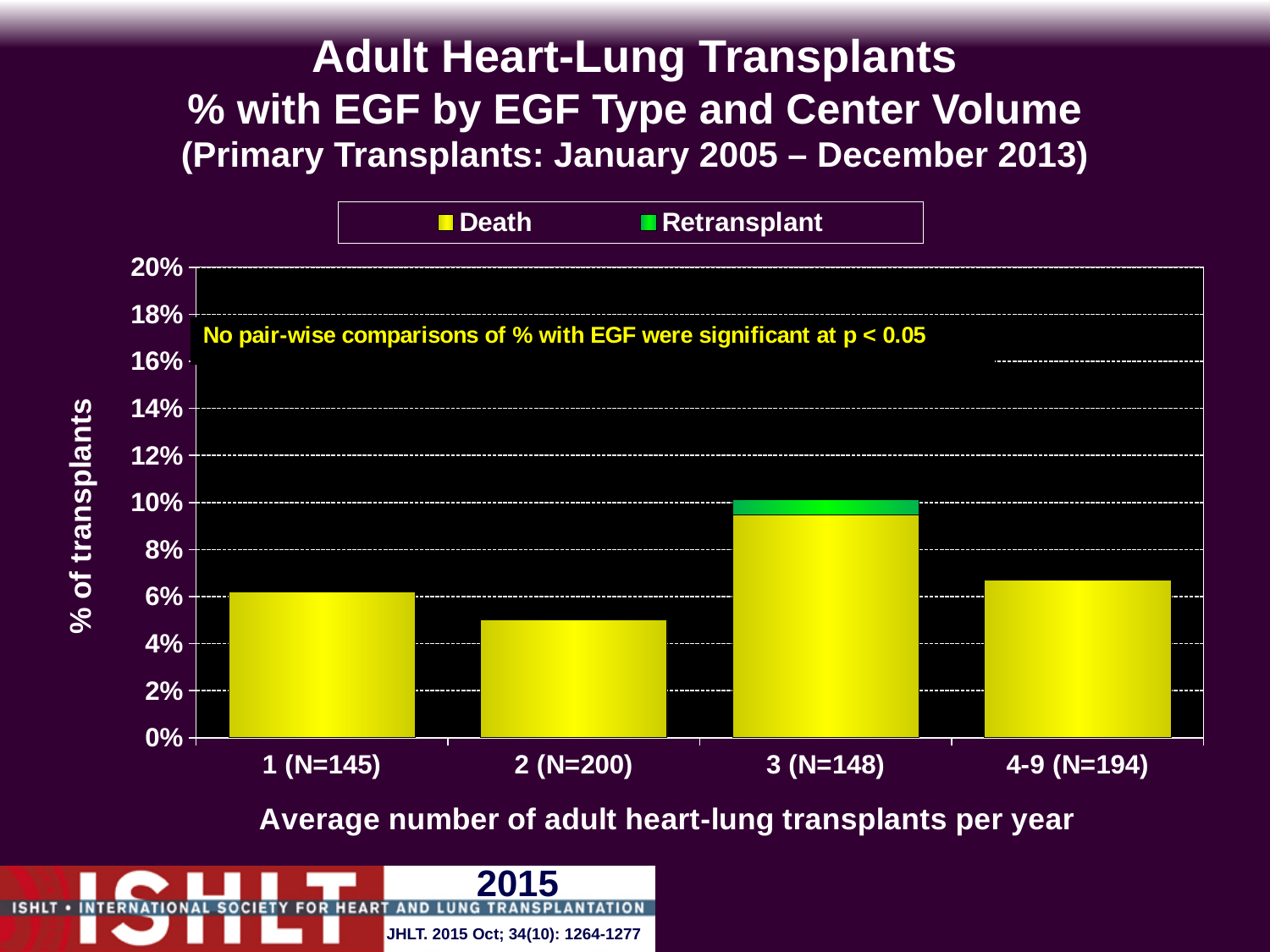
Is the total % with EGF for 1 (N=145) greater or less than 4%? greater Is the total % with EGF for 3 (N=148) greater or less than 8%? greater Which has a larger total % with EGF, 3 (N=148) or 2 (N=200)? 3 (N=148) Which center volume category has the lowest total % with EGF? 2 (N=200) Is the total % with EGF for 2 (N=200) greater or less than 6%? less What is the x-axis title of the chart? Average number of adult heart-lung transplants per year How many series does the legend list? 2 Which series is shown in green in the legend? Retransplant How many center volume categories are shown on the x axis? 4 Which center volume category has the highest total % with EGF? 3 (N=148) What kind of chart is shown on the slide? bar chart